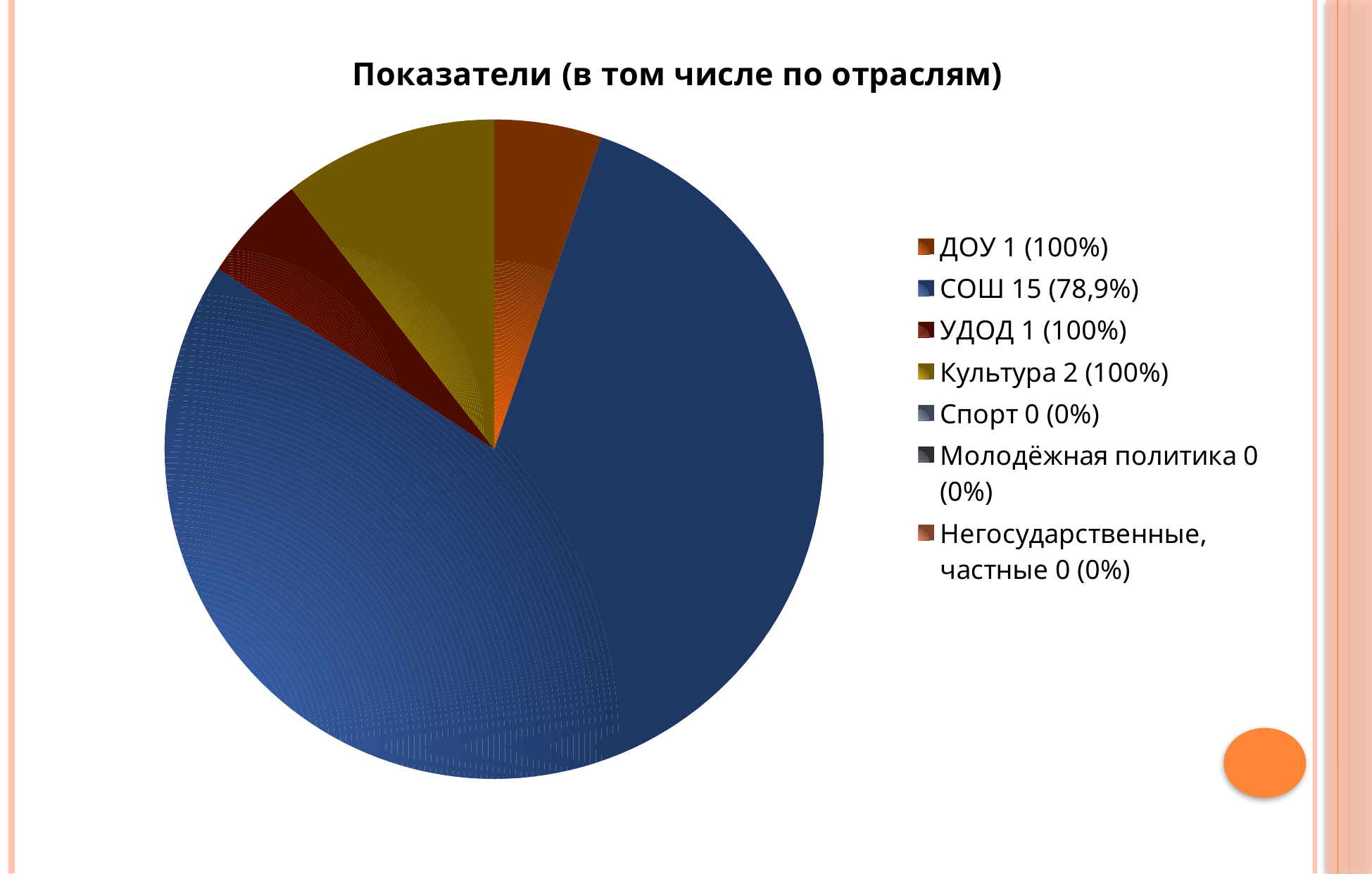
What number is shown for СОШ in the legend? 15 What number is shown for Культура in the legend? 2 What number is shown for Спорт in the legend? 0 What percentage is shown in parentheses for СОШ in the legend? 78,9% How many entries does the chart legend list? 7 How many legend categories have a value of 0? 3 What is the title of the chart? Показатели (в том числе по отраслям) What is the difference between the values for Культура and ДОУ? 1 Which has the larger value, Культура or УДОД? Культура What kind of chart is shown on the slide? pie chart What percentage is shown in parentheses for ДОУ in the legend? 100% Which category has the largest slice of the pie? СОШ